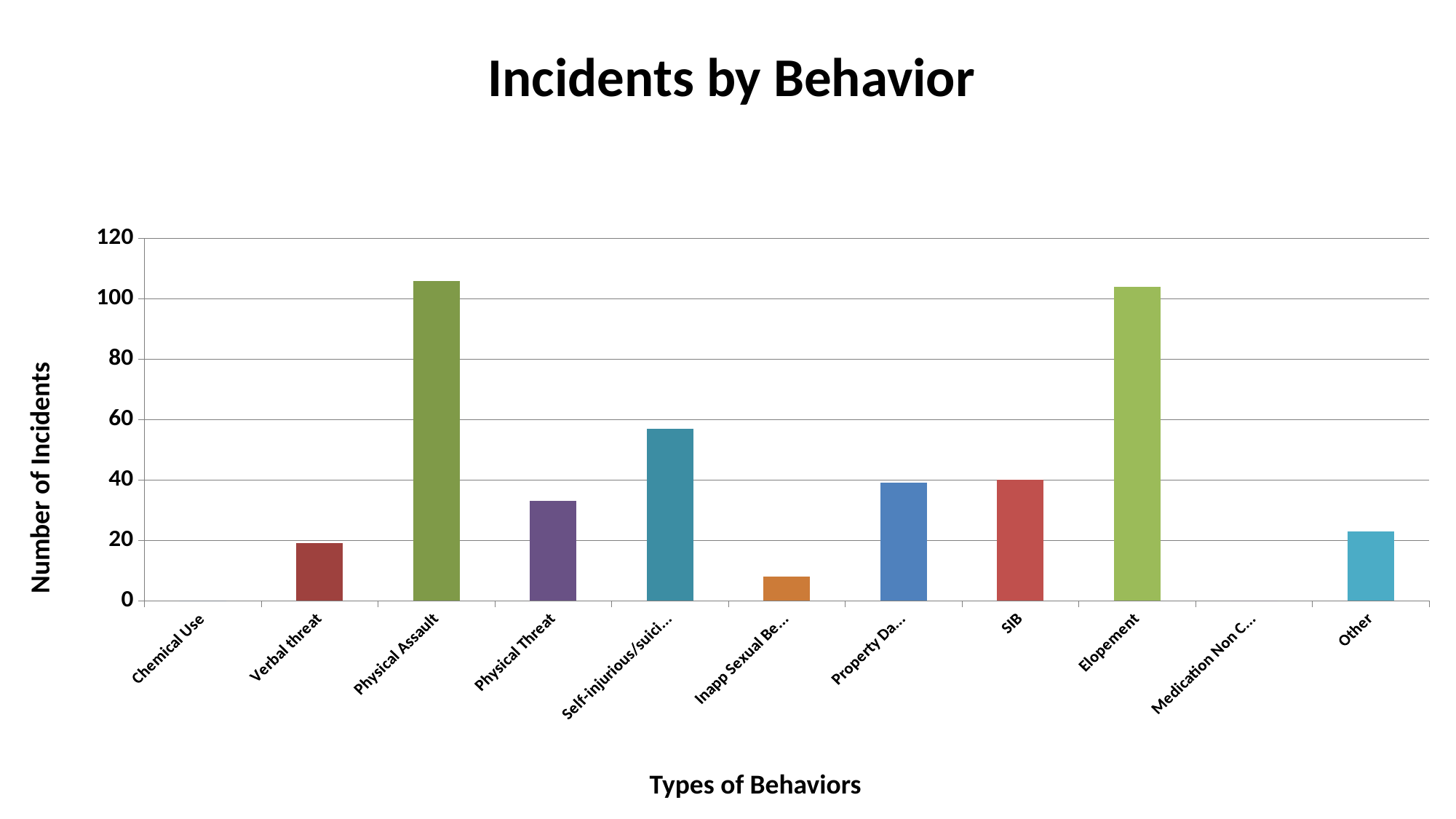
Is the value for Physical Assault greater or less than 100? greater Is the value for Inapp Sexual Be... greater or less than 20? less Which has more incidents, Inapp Sexual Be... or SIB? SIB Is the value for Elopement greater or less than 80? greater How many behavior categories are shown on the x axis? 11 What is the title of the chart? Incidents by Behavior What kind of chart is shown on the slide? bar chart Which has more incidents, Physical Threat or Self-injurious/suici...? Self-injurious/suici... What is the label on the vertical axis? Number of Incidents